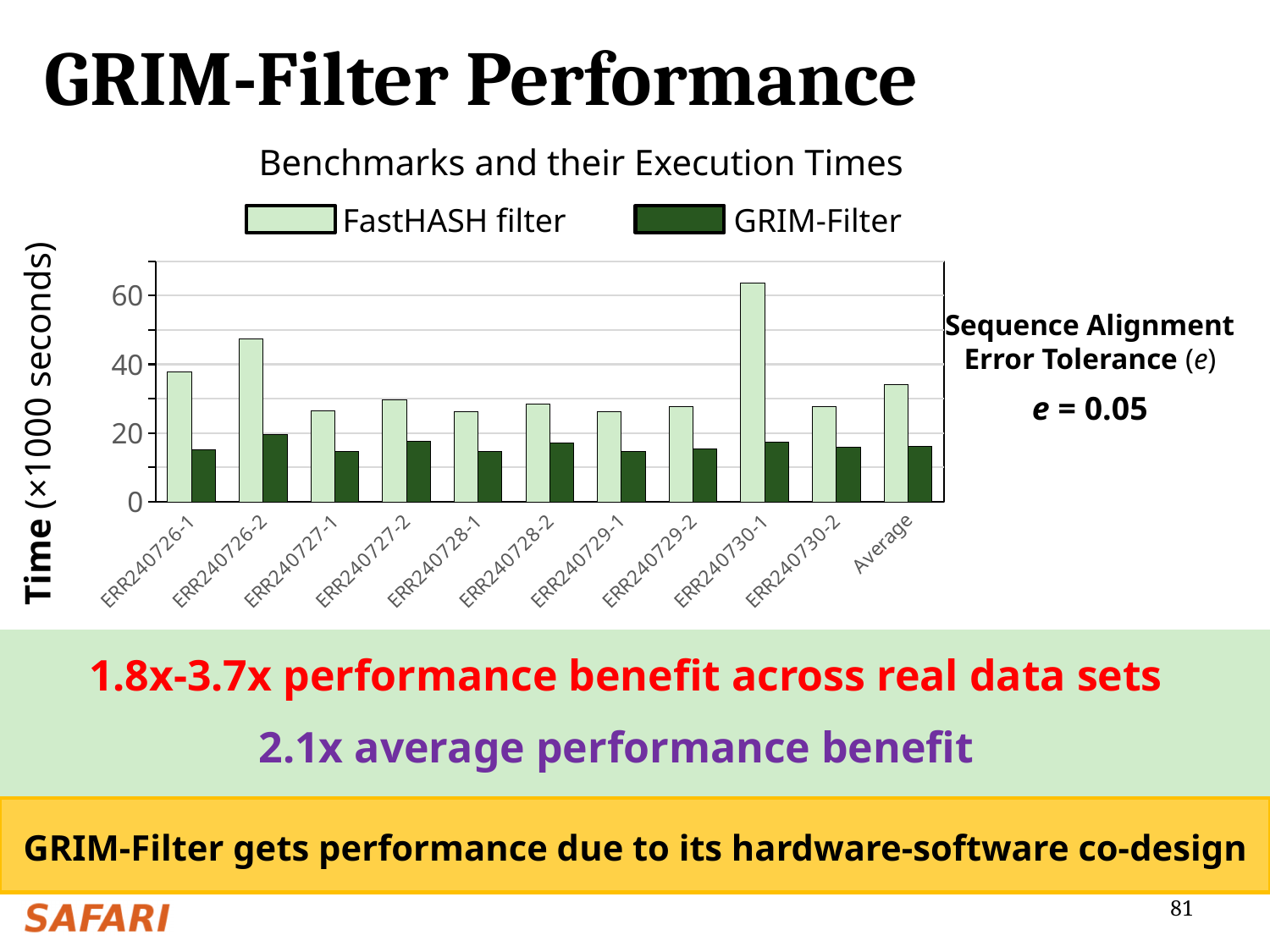
Which category has the highest FastHASH filter value? ERR240730-1 What kind of chart is shown on the slide? bar chart Is the FastHASH filter value for ERR240730-1 greater or less than 60? greater How many categories are shown on the x axis? 11 What is the title of the chart? Benchmarks and their Execution Times Is the FastHASH filter value for ERR240726-1 greater or less than 40? less Is the FastHASH filter value for ERR240726-2 greater or less than 40? greater For ERR240726-2, which series has the larger value, FastHASH filter or GRIM-Filter? FastHASH filter Which has the larger FastHASH filter value, ERR240726-1 or ERR240726-2? ERR240726-2 Which series is drawn in dark green? GRIM-Filter How many series does the legend list? 2